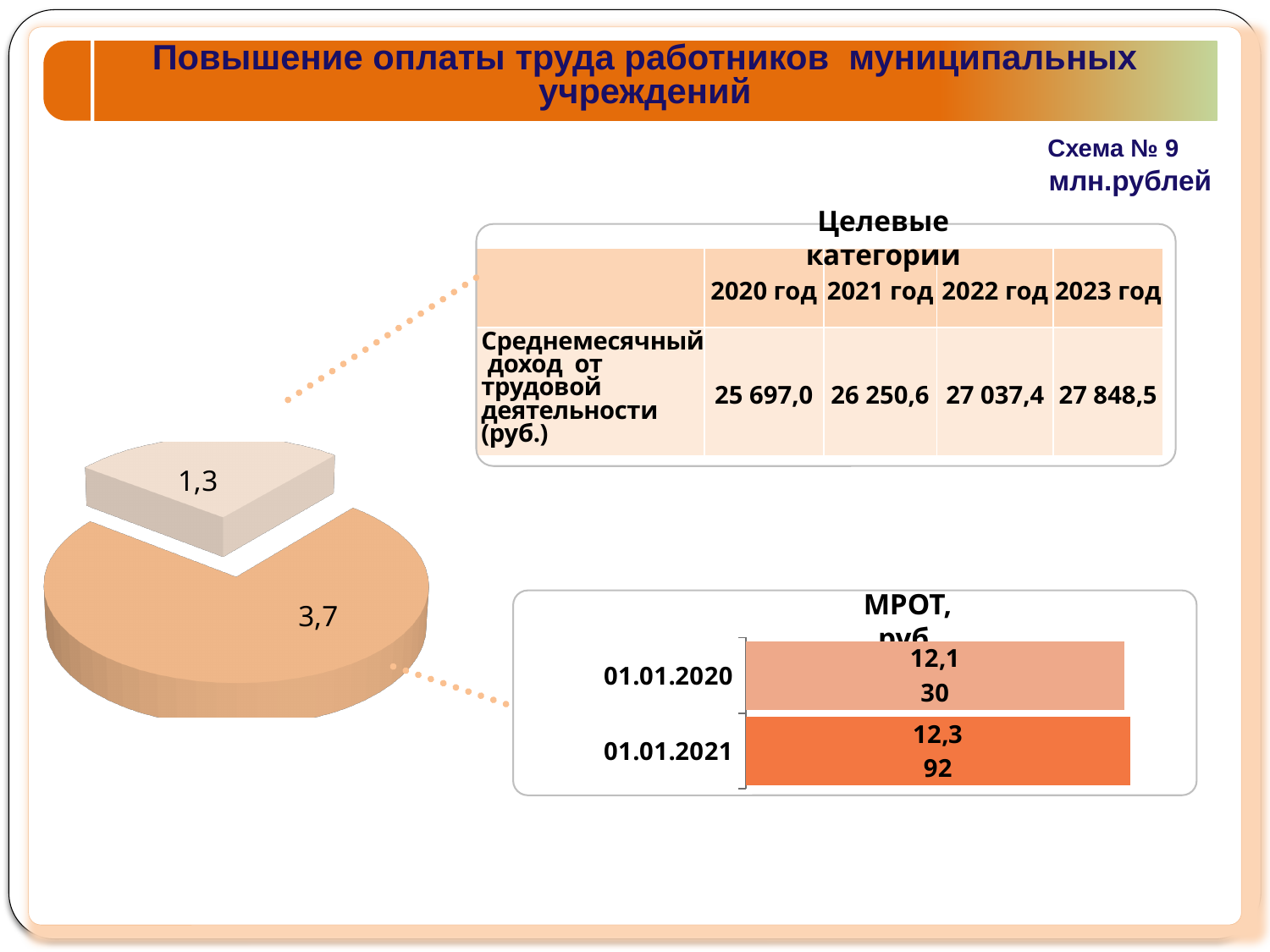
In the chart titled 'МРОТ, руб.', what is the value for 01.01.2021? 12,392 What kind of chart is the chart on the left of the slide? pie chart In the pie chart on the left, what is the value of the larger slice? 3,7 What kind of chart is the chart titled 'МРОТ, руб.'? bar chart In the pie chart on the left, what is the total of the two slice values? 5,0 In the pie chart on the left, what share of the whole does the slice labelled 3,7 represent? 74% How many bars does the chart titled 'МРОТ, руб.' have? 2 In the pie chart on the left, what is the value of the smaller slice? 1,3 In the chart titled 'МРОТ, руб.', which date has the larger value, 01.01.2020 or 01.01.2021? 01.01.2021 How many slices does the pie chart on the left have? 2 In the pie chart on the left, what is the difference between the two slice values? 2,4 In the chart titled 'МРОТ, руб.', what is the value for 01.01.2020? 12,130